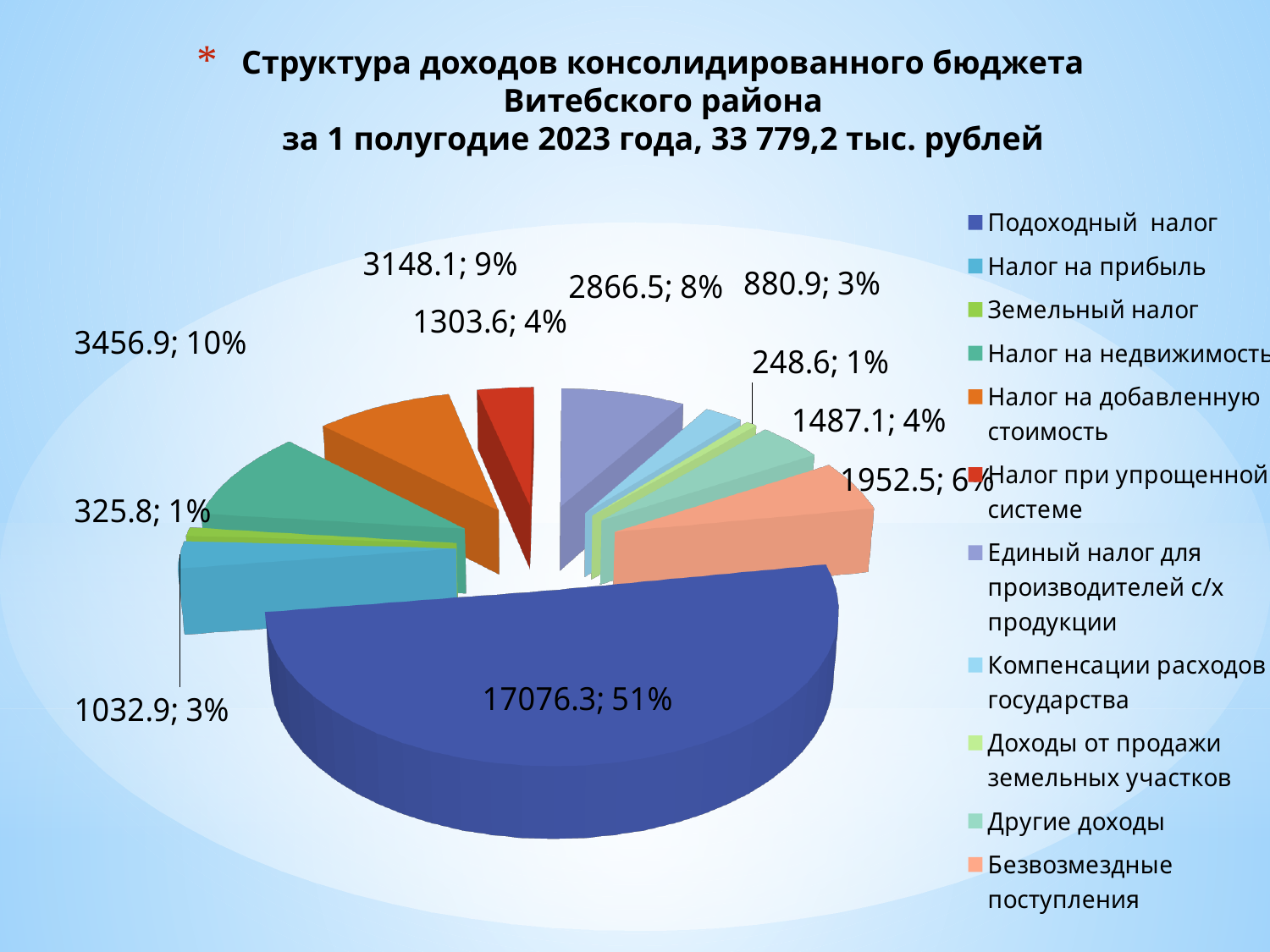
How many categories does the legend of the pie chart list? 11 What share of the pie does Подоходный налог account for? 51% What value is shown for Безвозмездные поступления? 1952.5 Which category has the smallest value in the pie chart? Доходы от продажи земельных участков What value is shown for Налог на добавленную стоимость? 3148.1 What kind of chart is shown on the slide? Pie chart What value is shown for Подоходный налог? 17076.3 What share of the pie does Единый налог для производителей с/х продукции account for? 8% What is the difference between the values for Подоходный налог and Безвозмездные поступления? 15123.8 According to the chart title, what is the total income of the consolidated budget for the first half of 2023? 33 779,2 тыс. рублей Which is larger: Налог на добавленную стоимость or Единый налог для производителей с/х продукции? Налог на добавленную стоимость Which category has the largest slice of the pie? Подоходный налог